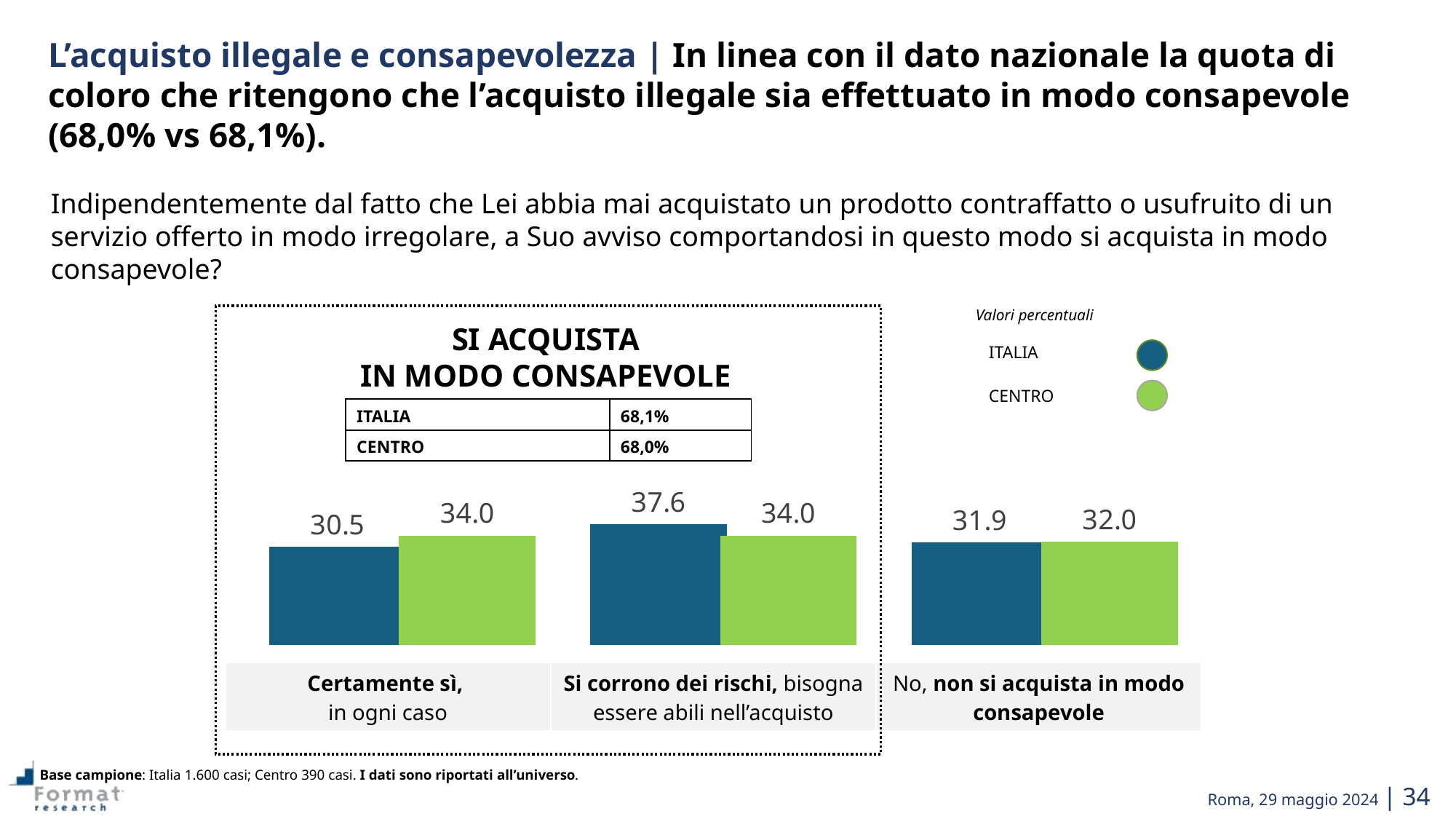
What is the value for ITALIA in the category "Certamente sì, in ogni caso"? 30.5 What is the difference between the ITALIA and CENTRO values in the category "Si corrono dei rischi, bisogna essere abili nell'acquisto"? 3.6 In the category "Si corrono dei rischi, bisogna essere abili nell'acquisto", which series has the larger value, ITALIA or CENTRO? ITALIA What is the value for CENTRO in the category "Si corrono dei rischi, bisogna essere abili nell'acquisto"? 34.0 What is the value for ITALIA in the category "No, non si acquista in modo consapevole"? 31.9 What is the difference between the ITALIA and CENTRO values in the category "Certamente sì, in ogni caso"? 3.5 Which category has the lowest value for ITALIA? Certamente sì, in ogni caso In the category "Certamente sì, in ogni caso", which series has the larger value, ITALIA or CENTRO? CENTRO What type of chart is shown on the slide? Bar chart How many categories are shown on the x axis of the chart? 3 Which category has the highest value for ITALIA? Si corrono dei rischi, bisogna essere abili nell'acquisto How many series does the legend list? 2